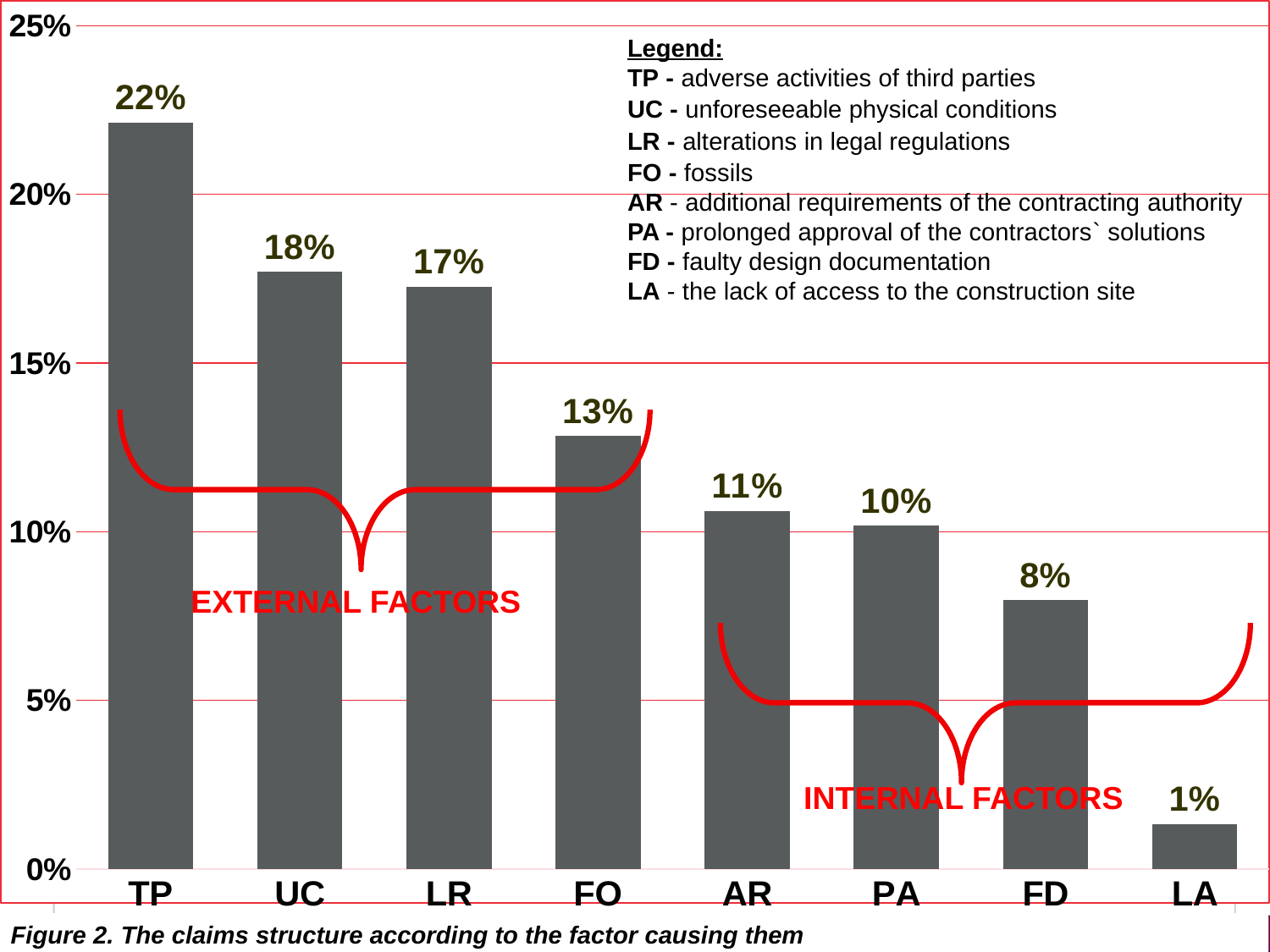
What is the value for FD? 8% Which is larger, the value for LR or the value for PA? LR Which category has the lowest value? LA What is the value for FO? 13% How many categories are shown on the x axis? 8 Do the values rise or fall from left to right along the x axis? fall According to the legend, what does the abbreviation FO stand for? fossils What is the value for TP? 22% Which category has the highest value? TP What kind of chart is this? bar chart What is the difference between the values for TP and UC? 4% What is the difference between the values for AR and LA? 10%